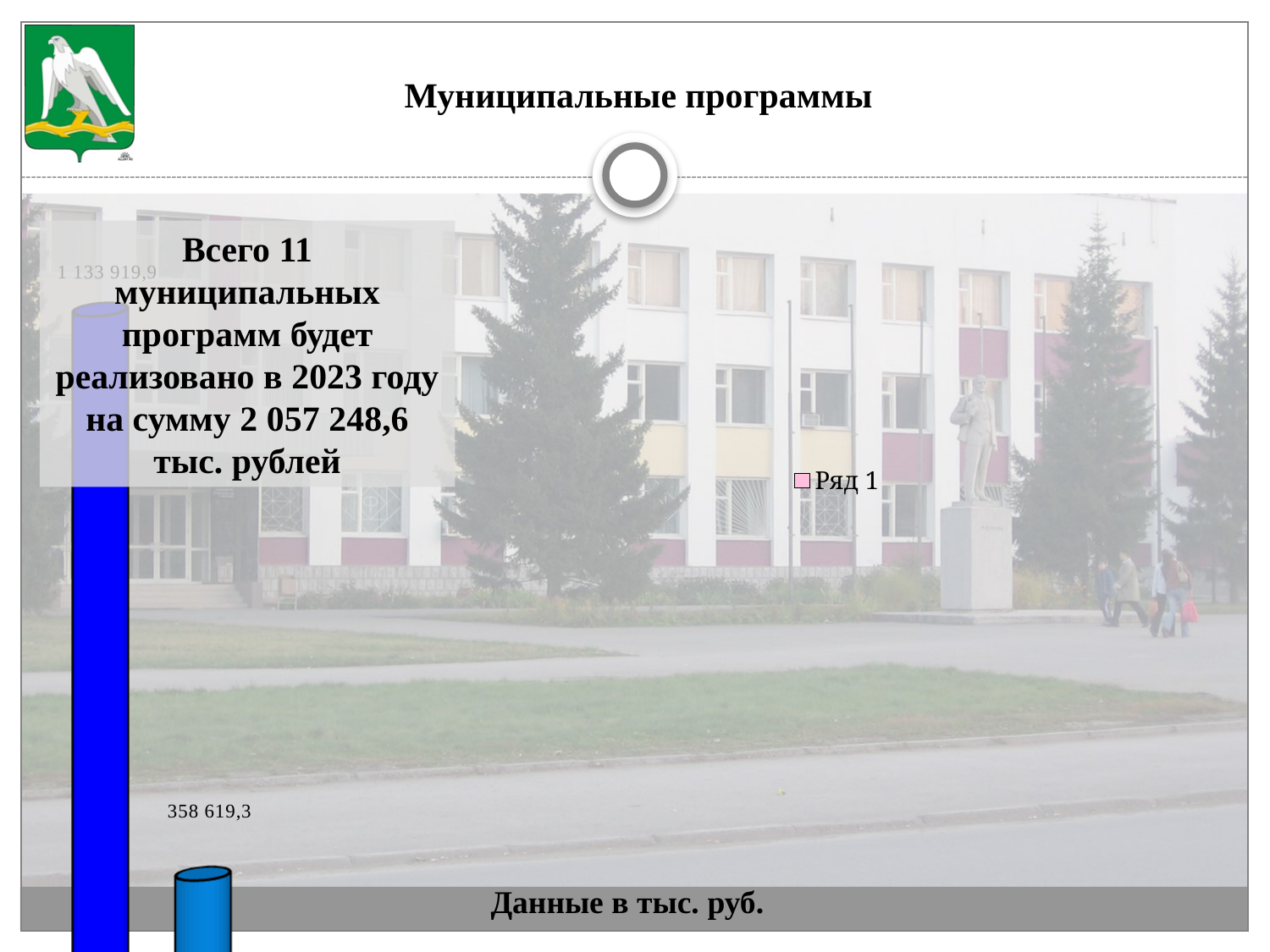
How many bars are visible in the chart on the slide? 2 How many series does the chart legend list? 1 What is the difference between the values 1 133 919,9 and 358 619,3 shown on the chart? 775 300,6 In what units are the chart data given, according to the note at the bottom of the slide? тыс. руб. What is the value labelled on the tallest bar in the chart? 1 133 919,9 What kind of chart is shown on the slide? bar chart What is the value labelled on the second bar from the left in the chart? 358 619,3 What is the name of the series shown in the chart legend? Ряд 1 What is the highest value labelled on the chart? 1 133 919,9 Which is larger: the value of the leftmost bar or the value of the second bar from the left? the leftmost bar (1 133 919,9)